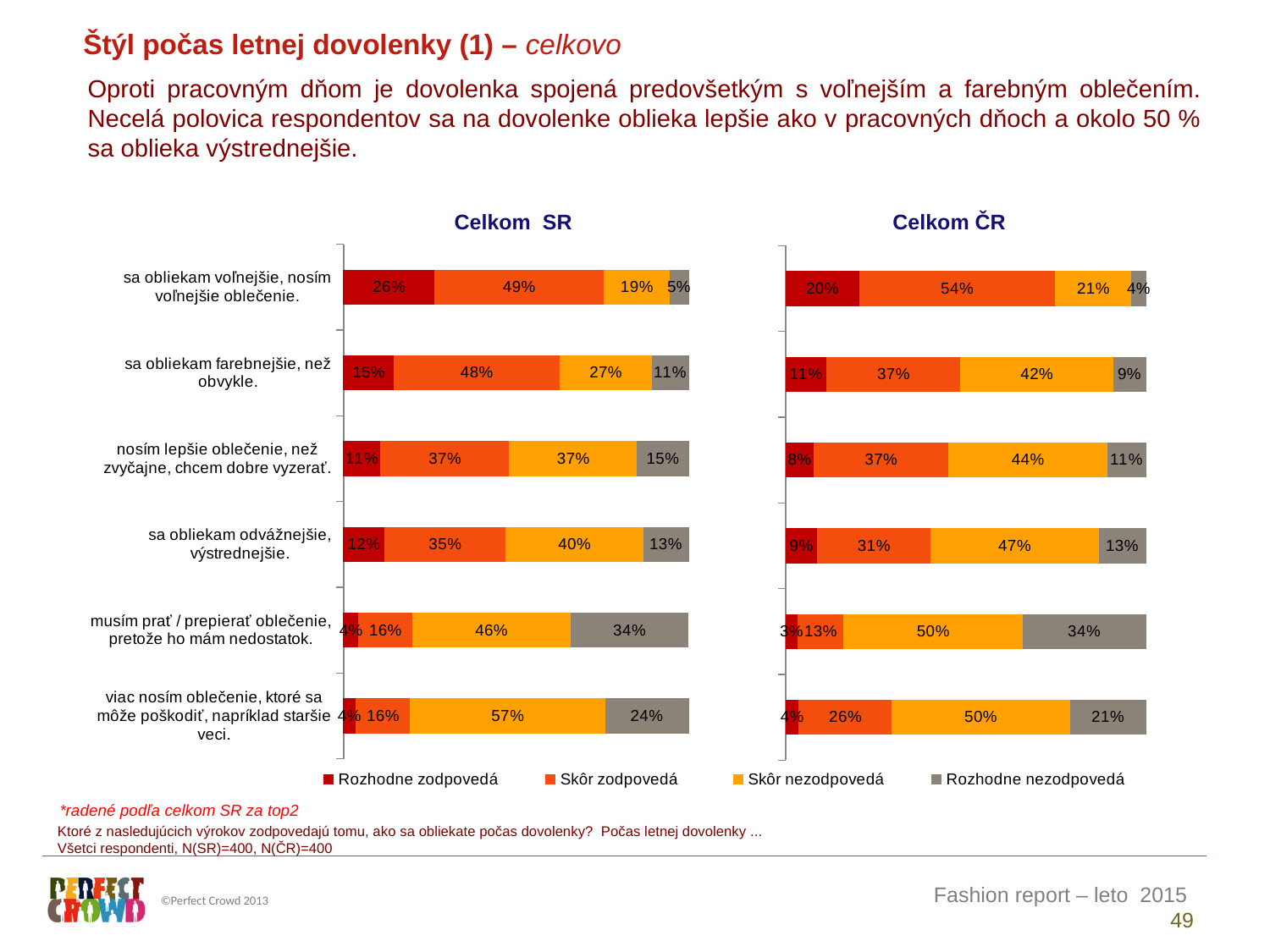
In the Celkom SR chart, which category has the highest 'Rozhodne zodpovedá' value? sa obliekam voľnejšie, nosím voľnejšie oblečenie How many series does the legend list? 4 In the Celkom ČR chart, which category has the lowest 'Rozhodne zodpovedá' value? musím prať / prepierať oblečenie, pretože ho mám nedostatok How many categories are shown in the Celkom SR chart? 6 In the Celkom SR chart, what is the combined 'Rozhodne zodpovedá' and 'Skôr zodpovedá' value for 'nosím lepšie oblečenie, než zvyčajne, chcem dobre vyzerať'? 48% In the Celkom ČR chart, what is the 'Skôr zodpovedá' value for 'sa obliekam voľnejšie, nosím voľnejšie oblečenie'? 54% In the Celkom ČR chart, what is the 'Rozhodne nezodpovedá' value for 'musím prať / prepierať oblečenie, pretože ho mám nedostatok'? 34% Which is larger: the 'Skôr nezodpovedá' value for 'sa obliekam farebnejšie, než obvykle' in the Celkom SR chart or in the Celkom ČR chart? Celkom ČR In the Celkom SR chart, what is the 'Skôr nezodpovedá' value for 'viac nosím oblečenie, ktoré sa môže poškodiť, napríklad staršie veci'? 57% In the Celkom SR chart, what is the difference between the 'Skôr zodpovedá' values for 'sa obliekam farebnejšie, než obvykle' and 'sa obliekam odvážnejšie, výstrednejšie'? 13% In the Celkom SR chart, what is the 'Rozhodne zodpovedá' value for 'sa obliekam voľnejšie, nosím voľnejšie oblečenie'? 26% What type of chart is the Celkom ČR chart? Stacked bar chart